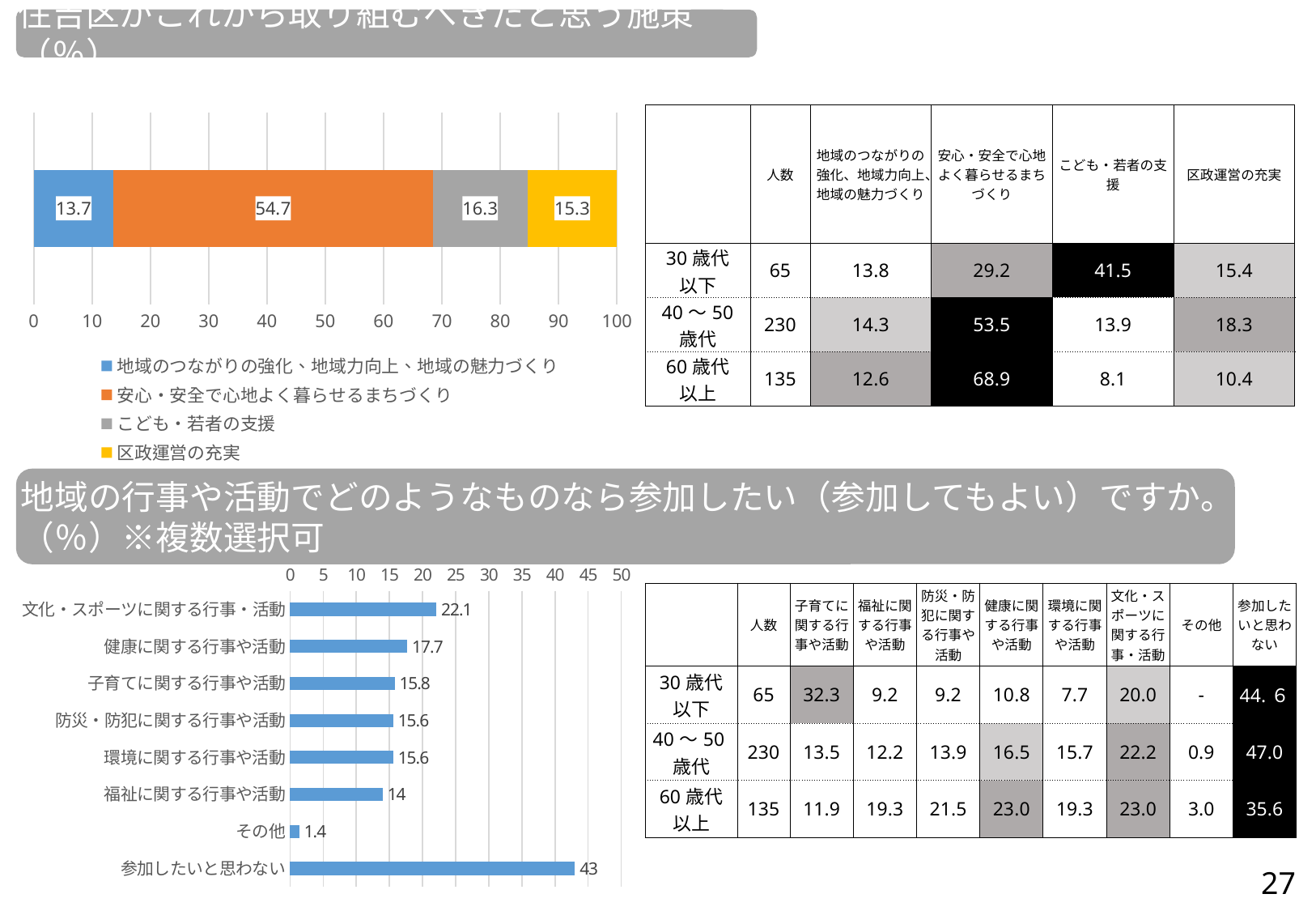
What kind of chart is shown at the bottom left of the slide (地域の行事や活動でどのようなものなら参加したい)? Bar chart In the stacked bar chart at the top left of the slide, which segment is the largest? 安心・安全で心地よく暮らせるまちづくり In the stacked bar chart at the top left of the slide, what is the value for 区政運営の充実? 15.3 In the stacked bar chart at the top left of the slide, what is the value for 安心・安全で心地よく暮らせるまちづくり? 54.7 In the bar chart at the bottom left of the slide (地域の行事や活動でどのようなものなら参加したい), what is the value for 健康に関する行事や活動? 17.7 In the stacked bar chart at the top left of the slide, which segment is the smallest? 地域のつながりの強化、地域力向上、地域の魅力づくり In the bar chart at the bottom left of the slide (地域の行事や活動でどのようなものなら参加したい), which category has the lowest value? その他 In the bar chart at the bottom left of the slide (地域の行事や活動でどのようなものなら参加したい), what is the difference between 文化・スポーツに関する行事・活動 and 福祉に関する行事や活動? 8.1 In the bar chart at the bottom left of the slide (地域の行事や活動でどのようなものなら参加したい), how many categories are shown? 8 In the stacked bar chart at the top left of the slide, how many series does the legend list? 4 In the bar chart at the bottom left of the slide (地域の行事や活動でどのようなものなら参加したい), which category has the highest value? 参加したいと思わない In the stacked bar chart at the top left of the slide, what is the total of the four segments? 100